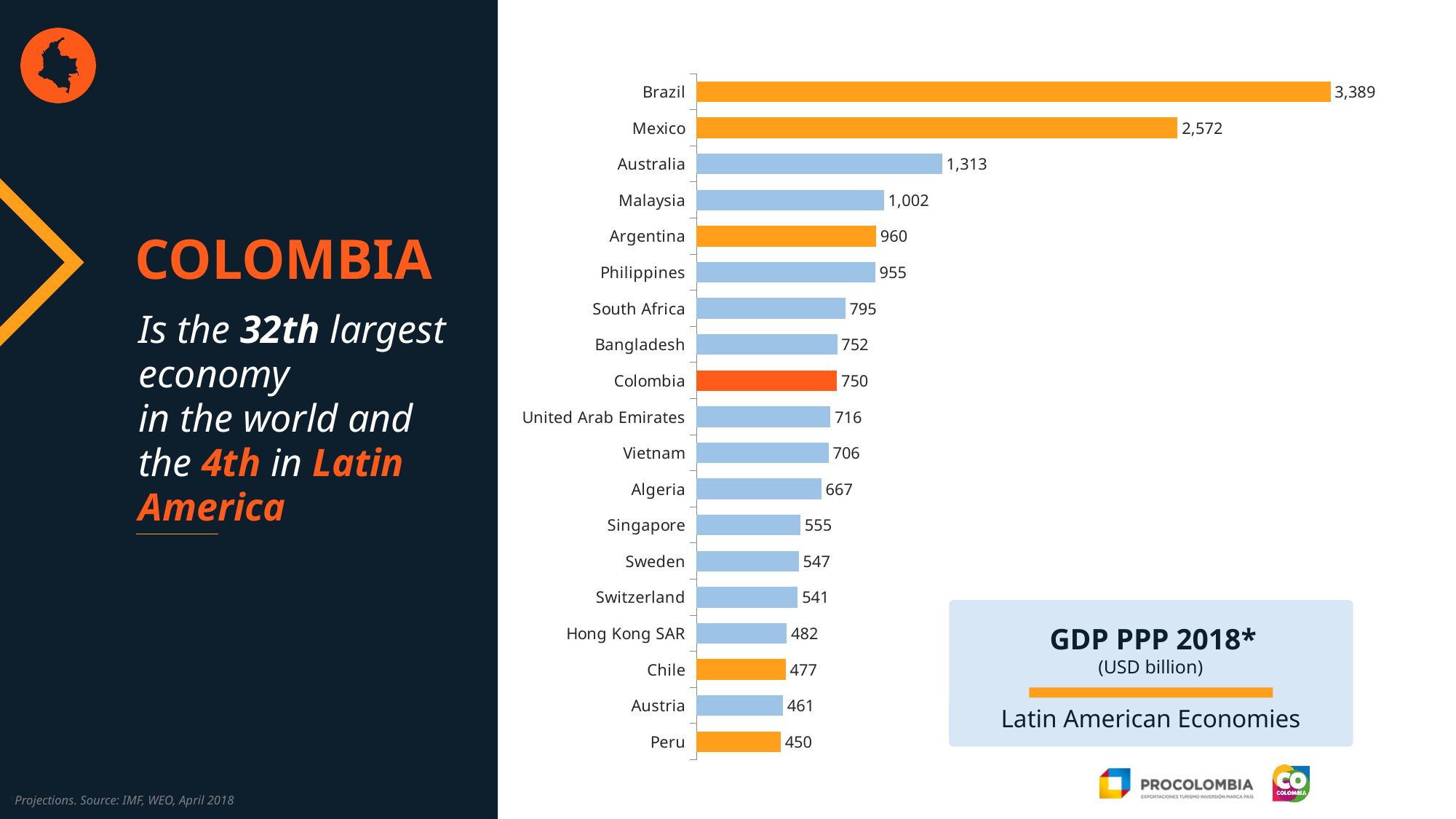
What unit is the GDP PPP 2018 chart measured in, according to the legend box? USD billion Which country has the highest GDP PPP 2018 value on the chart? Brazil Which has a larger GDP PPP 2018 value, Australia or Argentina? Australia What is the GDP PPP 2018 value for Colombia? 750 How many countries are shown on the chart? 19 What is the GDP PPP 2018 value for Malaysia? 1,002 Which has a larger GDP PPP 2018 value, Singapore or Hong Kong SAR? Singapore What type of chart is shown on the slide? Bar chart Which country has the lowest GDP PPP 2018 value on the chart? Peru What is the GDP PPP 2018 value for Mexico? 2,572 What is the difference between the GDP PPP 2018 values of Colombia and Chile? 273 What is the difference between the GDP PPP 2018 values of Brazil and Mexico? 817